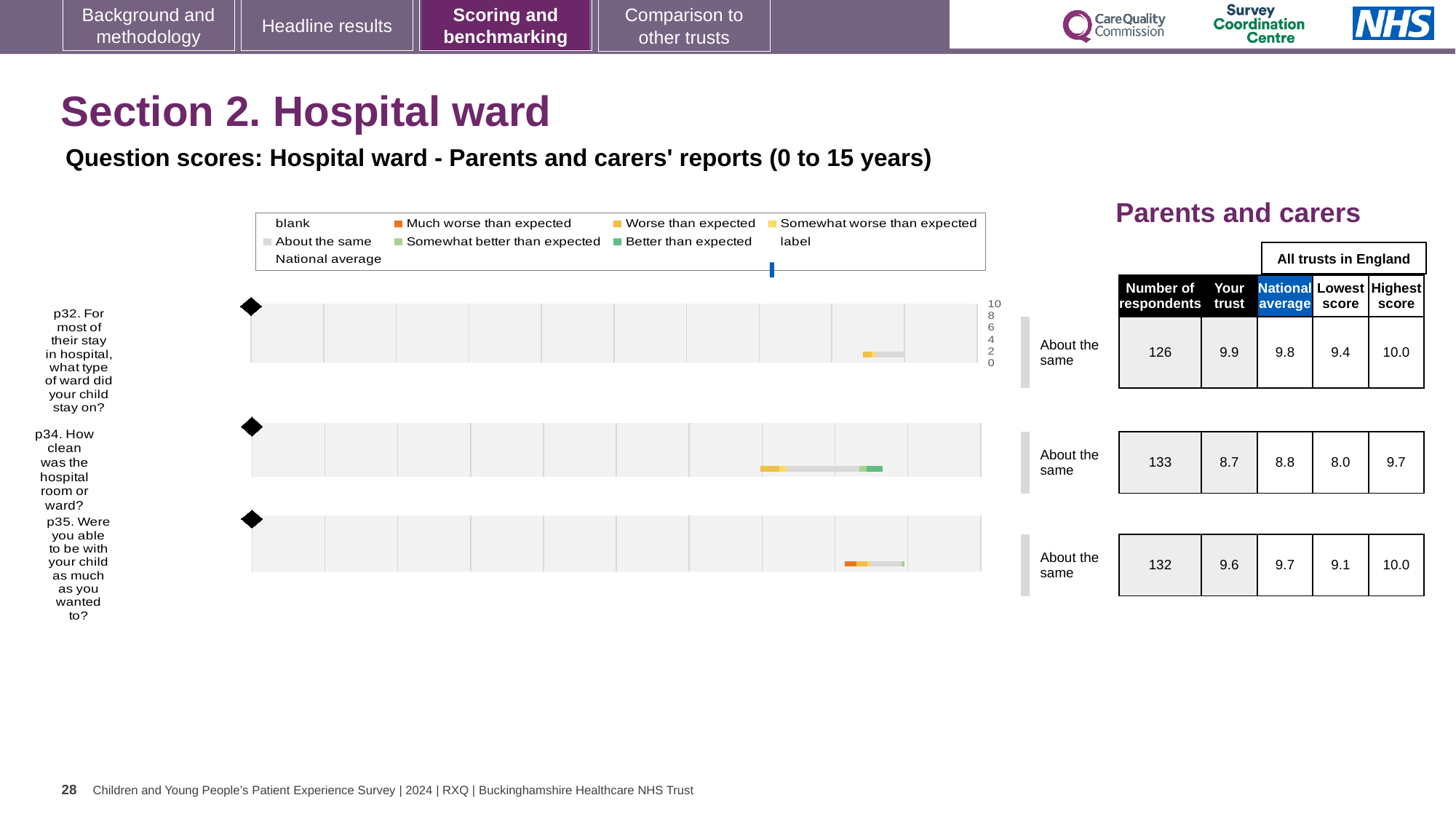
What is the highest score among all trusts in England for question p34? 9.7 What is the national average score for question p35 (Were you able to be with your child as much as you wanted to?)? 9.7 For question p32, which is larger: the 'Your trust' score or the national average? Your trust What is the lowest score among all trusts in England for question p32? 9.4 What kind of chart is used to show the question scores on this slide? Bar chart Which of the three questions shown has the lowest 'Your trust' score? p34 How many respondents are shown for question p32 (For most of their stay in hospital, what type of ward did your child stay on?)? 126 Which of the three questions shown has the highest 'Your trust' score? p32 What benchmark category is given for question p35? About the same For question p34, what is the difference between the national average and the 'Your trust' score? 0.1 What is the 'Your trust' score for question p34 (How clean was the hospital room or ward?)? 8.7 How many survey questions are charted on this slide? 3